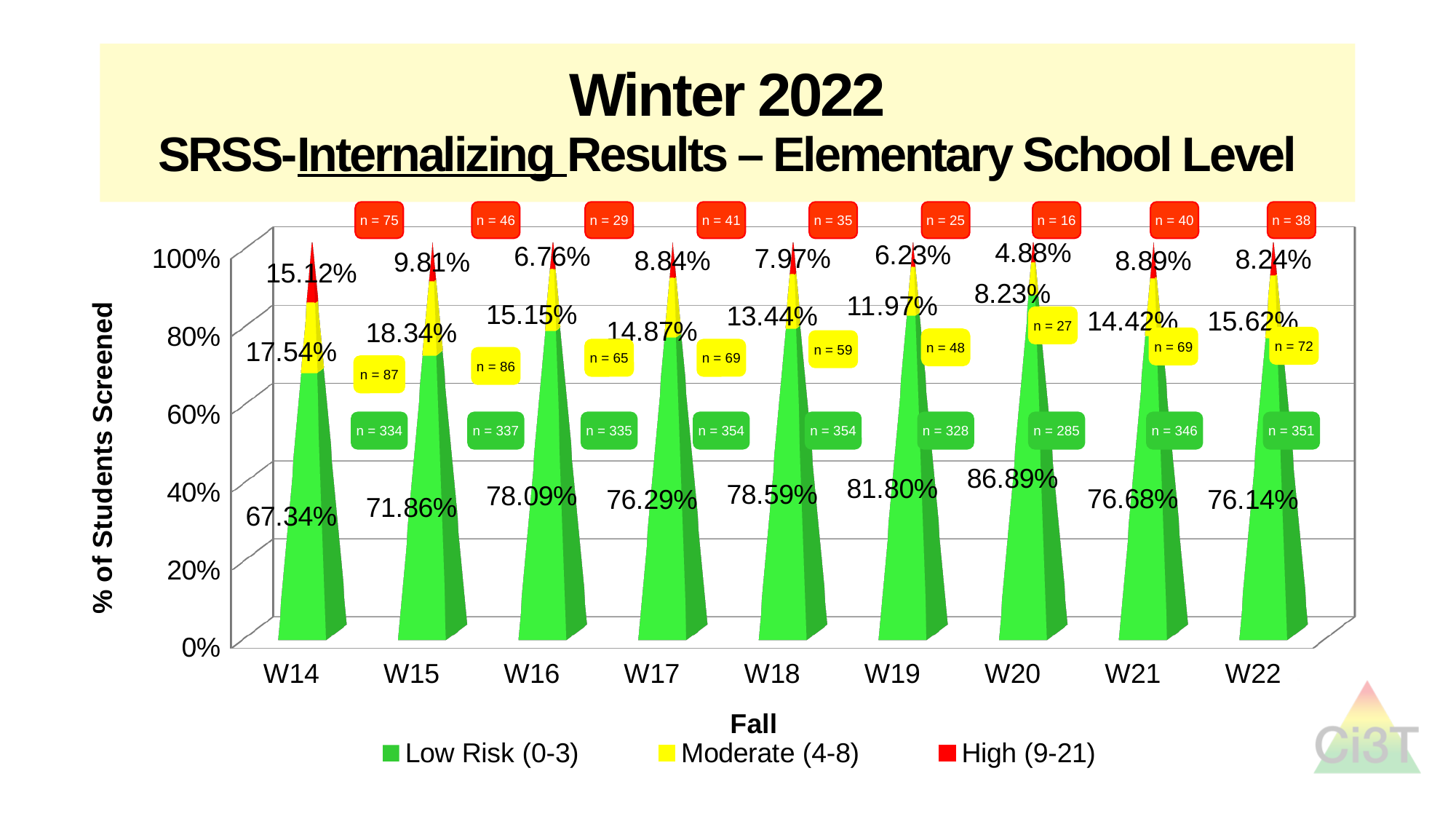
Which has the larger Moderate (4-8) percentage, W15 or W16? W15 Which school has the lowest Low Risk (0-3) percentage? W14 Which school has the highest Low Risk (0-3) percentage? W20 What is the difference in percentage points between the Low Risk (0-3) values for W20 and W14? 19.55 What is the High (9-21) percentage for W20? 4.88% What is the Low Risk (0-3) percentage for W14? 67.34% What is the n value shown for the Moderate (4-8) group at W18? n = 59 How many series does the legend list? 3 What is the Moderate (4-8) percentage for W22? 15.62% What kind of chart is shown on the slide? Stacked bar chart How many schools are shown on the x axis? 9 Which school has the highest High (9-21) percentage? W14